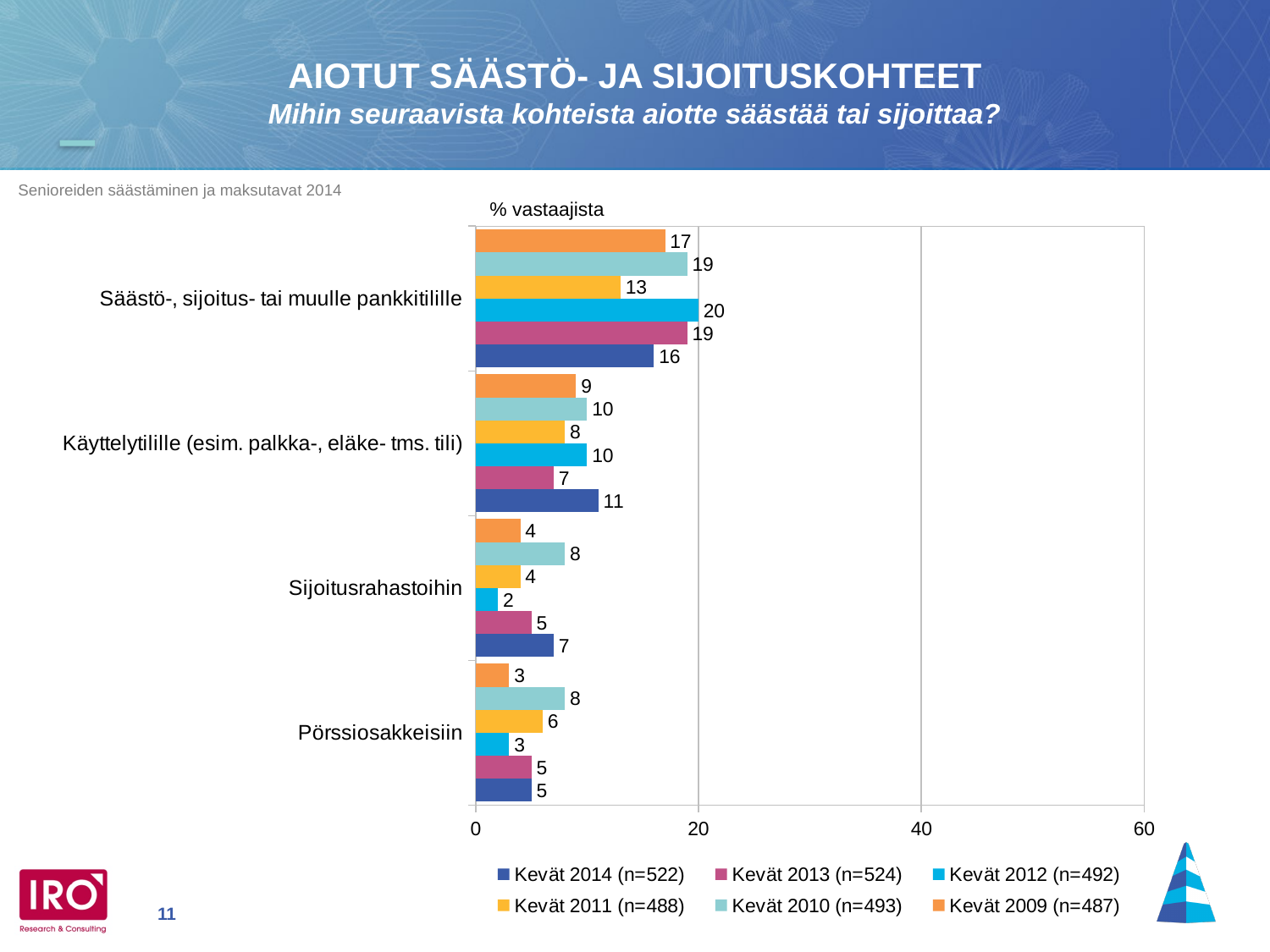
What is the value for Kevät 2014 (n=522) for Säästö-, sijoitus- tai muulle pankkitilille? 16 Which series has the lowest value for Käyttelytilille (esim. palkka-, eläke- tms. tili)? Kevät 2013 (n=524) What is the difference between the Kevät 2012 (n=492) and Kevät 2011 (n=488) values for Säästö-, sijoitus- tai muulle pankkitilille? 7 Which series has the highest value for Säästö-, sijoitus- tai muulle pankkitilille? Kevät 2012 (n=492) For Pörssiosakkeisiin, which is larger: the Kevät 2010 (n=493) value or the Kevät 2009 (n=487) value? Kevät 2010 (n=493) What kind of chart is shown on the slide? Bar chart Is the value for Kevät 2013 (n=524) for Säästö-, sijoitus- tai muulle pankkitilille greater or less than 20? less What is the value for Kevät 2011 (n=488) for Pörssiosakkeisiin? 6 What is the label on the value axis of the chart? % vastaajista How many series does the legend list? 6 How many categories are shown on the chart? 4 What is the value for Kevät 2012 (n=492) for Sijoitusrahastoihin? 2